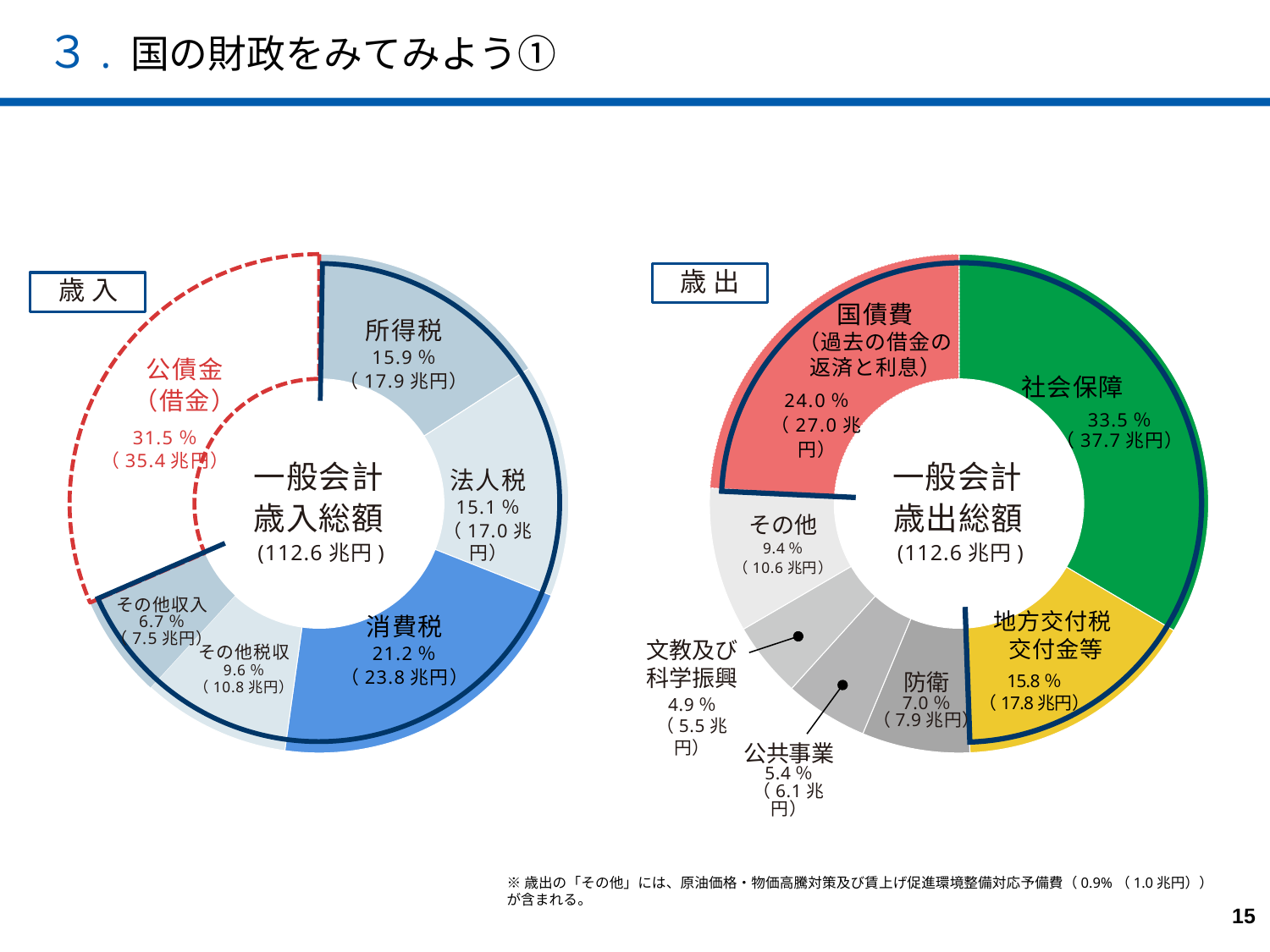
In the 歳入 chart, how many categories are shown? 6 In the 歳入 chart, what percentage share does 消費税 have? 21.2 % What kind of chart is used for 歳入 and 歳出 on this slide? Donut (pie) chart In the 歳入 chart, what is the difference in percentage points between 所得税 and 法人税? 0.8 In the 歳出 chart, what percentage share does 社会保障 have? 33.5 % In the 歳出 chart, which category has the smallest share? 文教及び科学振興 In the 歳出 chart, what is the amount shown for 国債費? 27.0 兆円 In the 歳入 chart, which category has the largest share? 公債金（借金） In the 歳入 chart, what is the amount shown for 公債金（借金）? 35.4 兆円 In the 歳入 chart, which category has the smallest share? その他収入 In the 歳出 chart, what is the difference in percentage points between 社会保障 and 国債費? 9.5 In the 歳出 chart, which is larger, 防衛 or 公共事業? 防衛